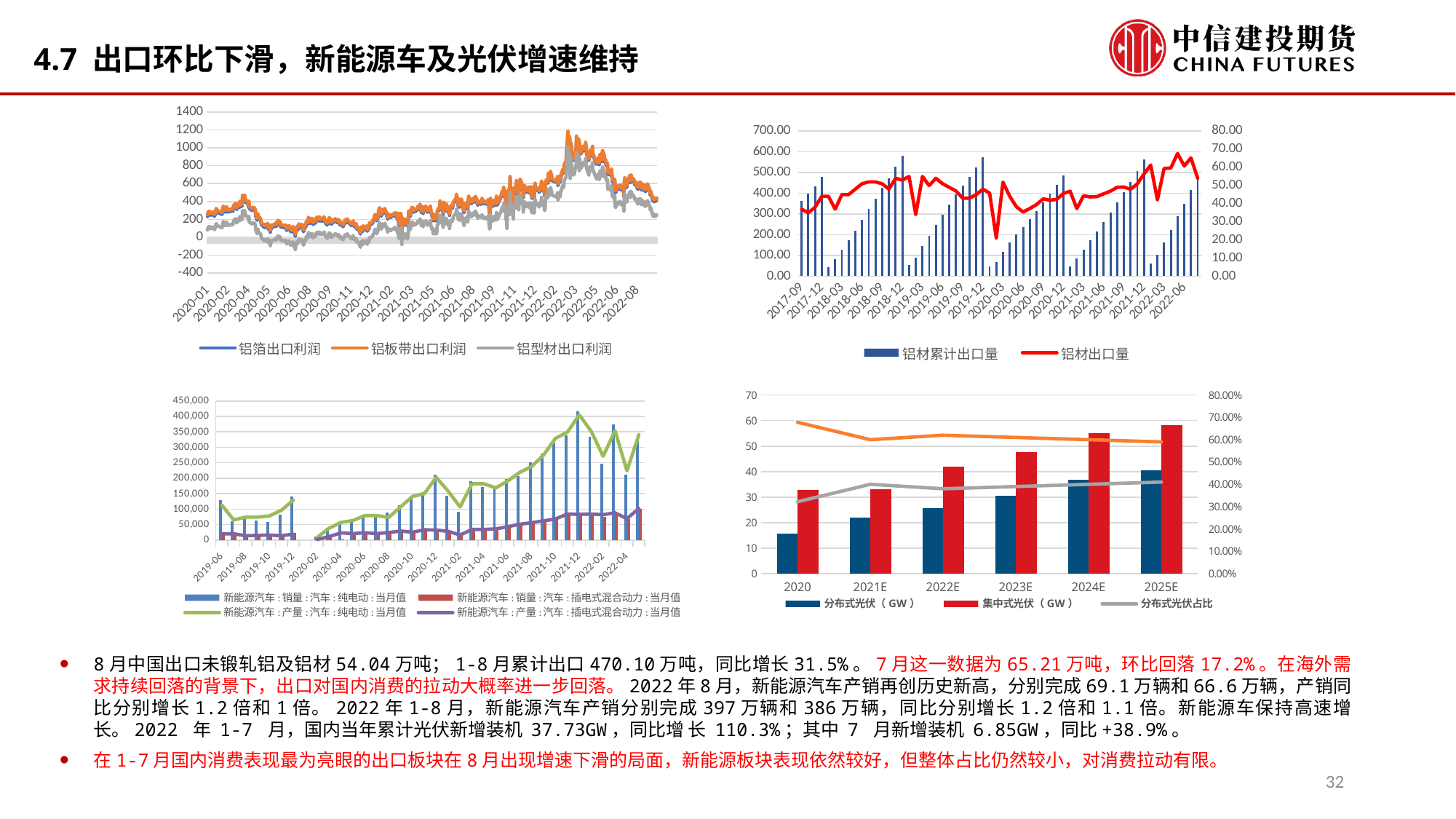
In the bottom-right chart, do the values for 集中式光伏（GW） rise or fall from 2020 to 2025E? rise In the bottom-right chart, which category has the lowest value for 分布式光伏（GW）? 2020 How many categories are shown on the x axis of the bottom-right chart? 6 How many series does the legend of the top-left chart list? 3 In the bottom-right chart, is the value for 分布式光伏（GW） in 2020 greater or less than 20? less What kind of chart is the top-left chart? line chart How many series does the legend of the bottom-right chart list? 3 In the bottom-right chart, is the value for 集中式光伏（GW） in 2025E greater or less than 50? greater How many series does the legend of the bottom-left chart list? 4 In the top-left chart, is the peak value of 铝板带出口利润 greater or less than 1000? greater In the bottom-right chart, which category has the highest value for 集中式光伏（GW）? 2025E In the bottom-right chart, which is larger in 2020: 分布式光伏（GW） or 集中式光伏（GW）? 集中式光伏（GW）